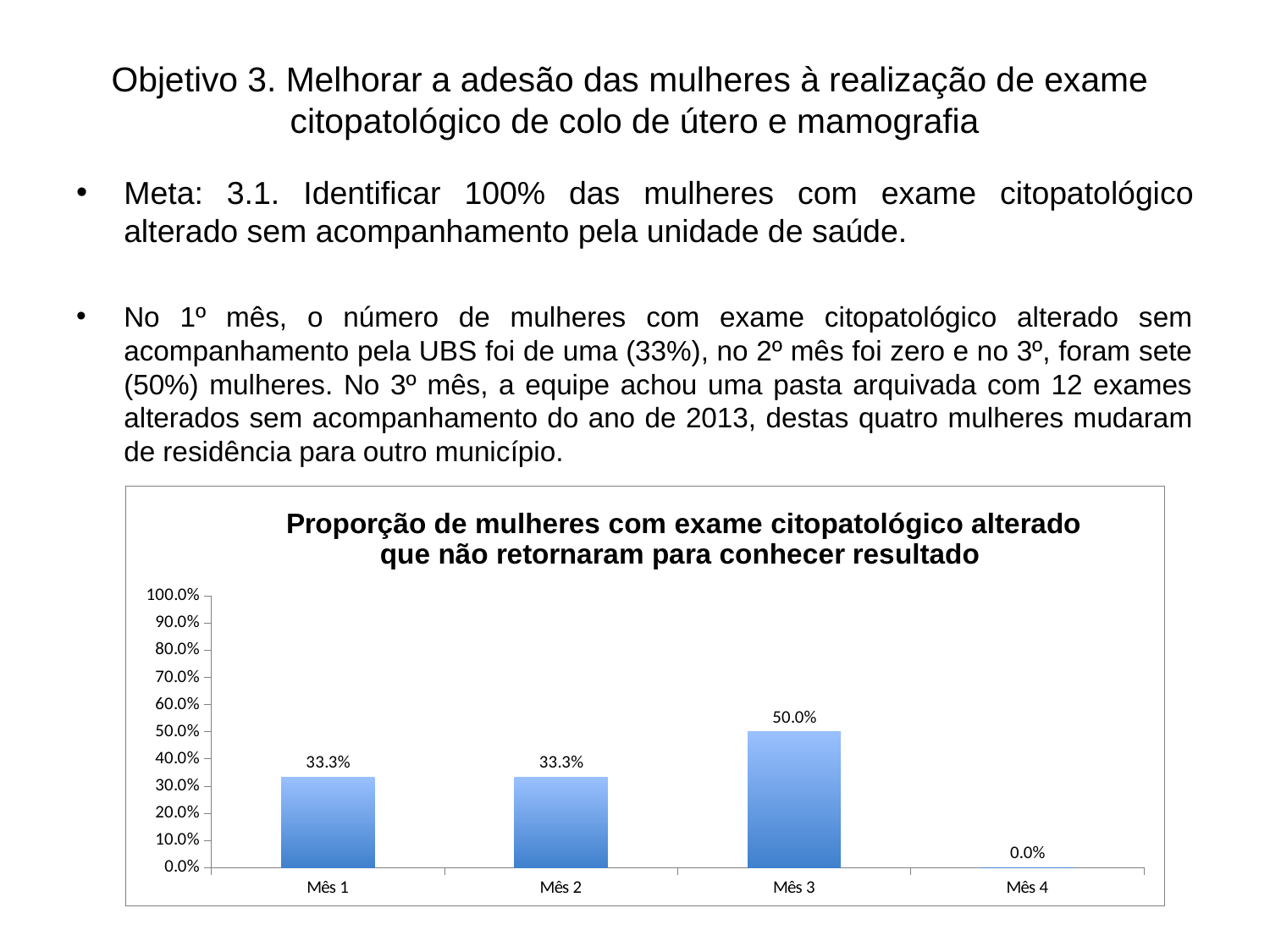
What is the value for Mês 4? 0.0% What is the value for Mês 1? 33.3% What is the difference between the values for Mês 3 and Mês 1? 16.7% Is the value for Mês 3 greater or less than 40.0%? greater Which is larger, the value for Mês 2 or the value for Mês 3? Mês 3 Which month has the lowest value? Mês 4 What kind of chart is shown on the slide? bar chart Which month has the highest value? Mês 3 What is the highest value shown on the y axis? 100.0% How many months are shown on the x axis? 4 What is the title of the chart? Proporção de mulheres com exame citopatológico alterado que não retornaram para conhecer resultado What is the value for Mês 3? 50.0%